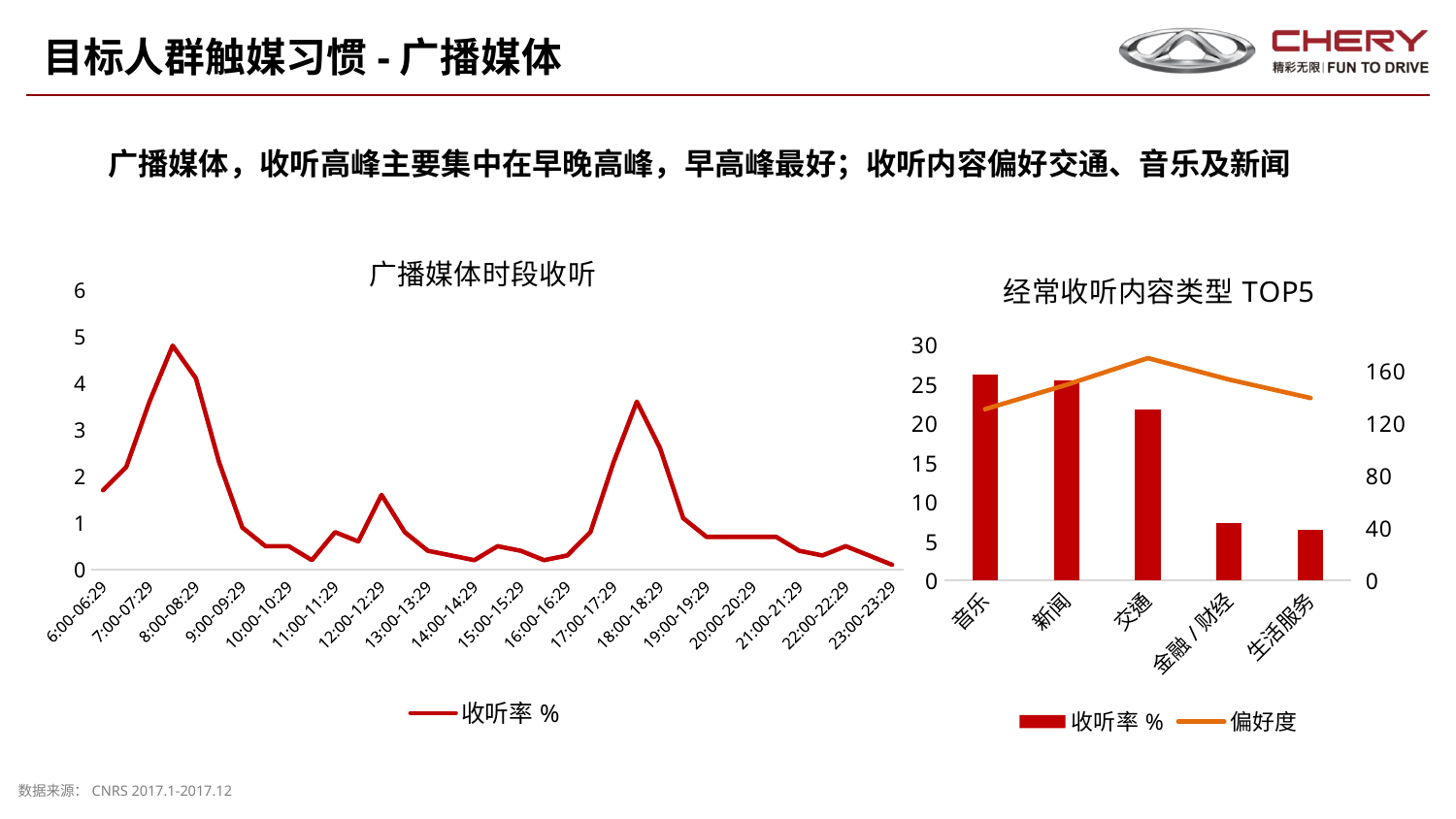
What kind of chart is the left chart titled 广播媒体时段收听? line chart In the left chart 广播媒体时段收听, which time slot has the lowest 收听率 %? 23:00-23:29 In the right chart 经常收听内容类型 TOP5, which category has the highest 收听率 % bar? 音乐 In the left chart 广播媒体时段收听, is the value for 14:00-14:29 greater or less than 1? less How many series does the legend of the right chart 经常收听内容类型 TOP5 list? 2 In the left chart 广播媒体时段收听, is the value for 18:00-18:29 greater or less than 3? less How many time slots are shown on the x axis of the left chart 广播媒体时段收听? 18 In the right chart 经常收听内容类型 TOP5, which category has the highest 偏好度? 交通 In the right chart 经常收听内容类型 TOP5, is the 收听率 % for 交通 greater or less than 25? less In the left chart 广播媒体时段收听, which is larger, the value for 8:00-08:29 or the value for 18:00-18:29? 8:00-08:29